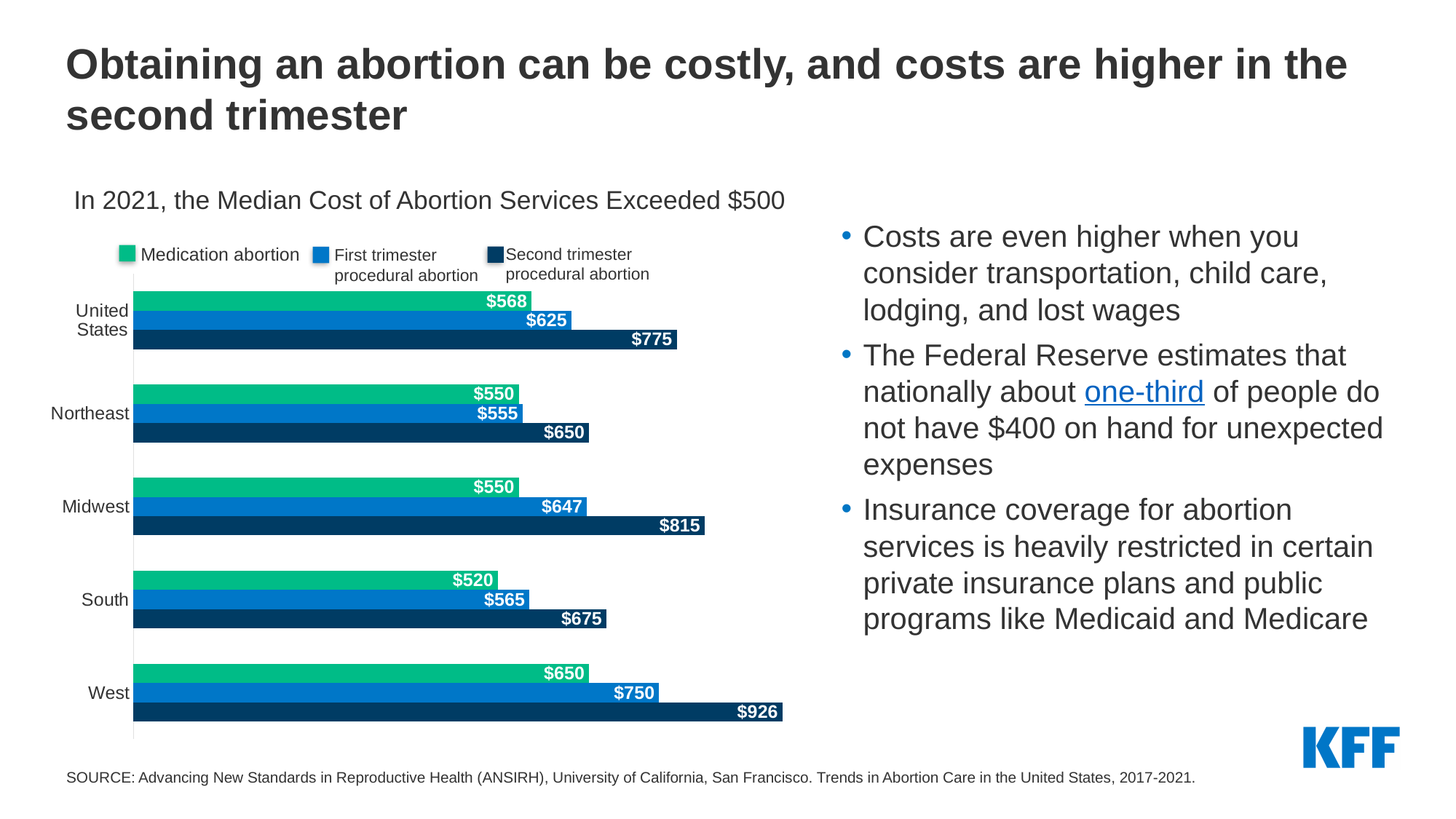
Which series is shown in green in the legend? Medication abortion What is the title of the chart? In 2021, the Median Cost of Abortion Services Exceeded $500 What is the median cost of a medication abortion in the United States overall? $568 Which region has the highest median cost for a second trimester procedural abortion? West Which region has the lowest median cost for a medication abortion? South How many regions or categories are shown on the chart? 5 How many series does the legend list? 3 Which is larger: the first trimester procedural abortion cost in the West or in the Northeast? West What is the median cost of a second trimester procedural abortion in the West? $926 What is the difference between the second trimester and first trimester procedural abortion costs in the Midwest? $168 What kind of chart is shown on the slide? Bar chart What is the median cost of a first trimester procedural abortion in the Midwest? $647